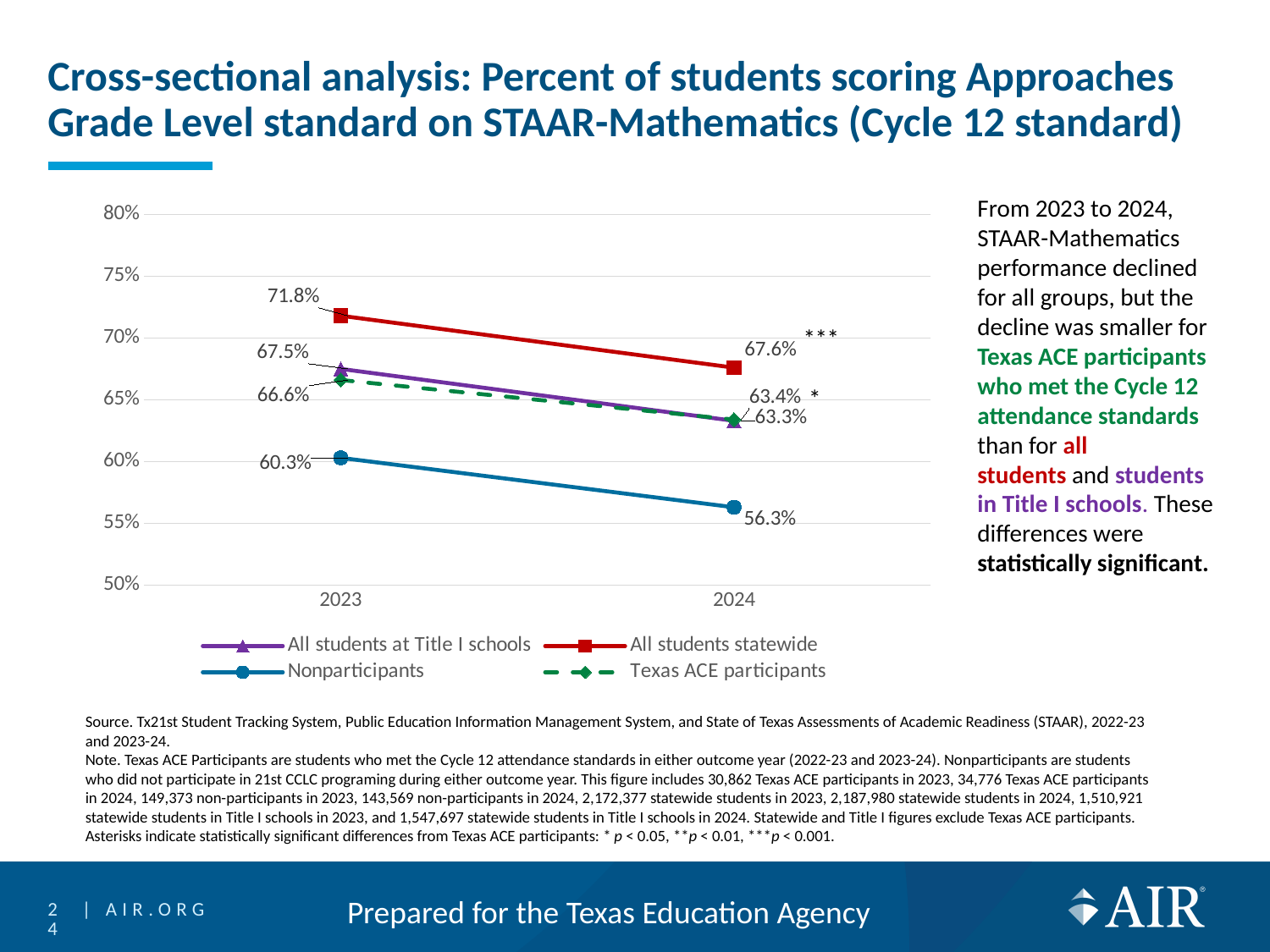
What was the value for All students at Title I schools in 2023? 67.5% By how many percentage points did the value for Nonparticipants change from 2023 to 2024? 4.0 percentage points By how many percentage points did the value for All students statewide change from 2023 to 2024? 4.2 percentage points What was the value for Texas ACE participants in 2023? 66.6% How many series does the legend list? 4 What was the value for All students statewide in 2023? 71.8% Which series is drawn with a dashed line? Texas ACE participants What kind of chart is shown on the slide? Line chart Which group had the lowest value in 2024? Nonparticipants What was the value for Nonparticipants in 2024? 56.3% Does the line for All students statewide rise or fall from 2023 to 2024? Fall Which group had the highest value in 2023? All students statewide